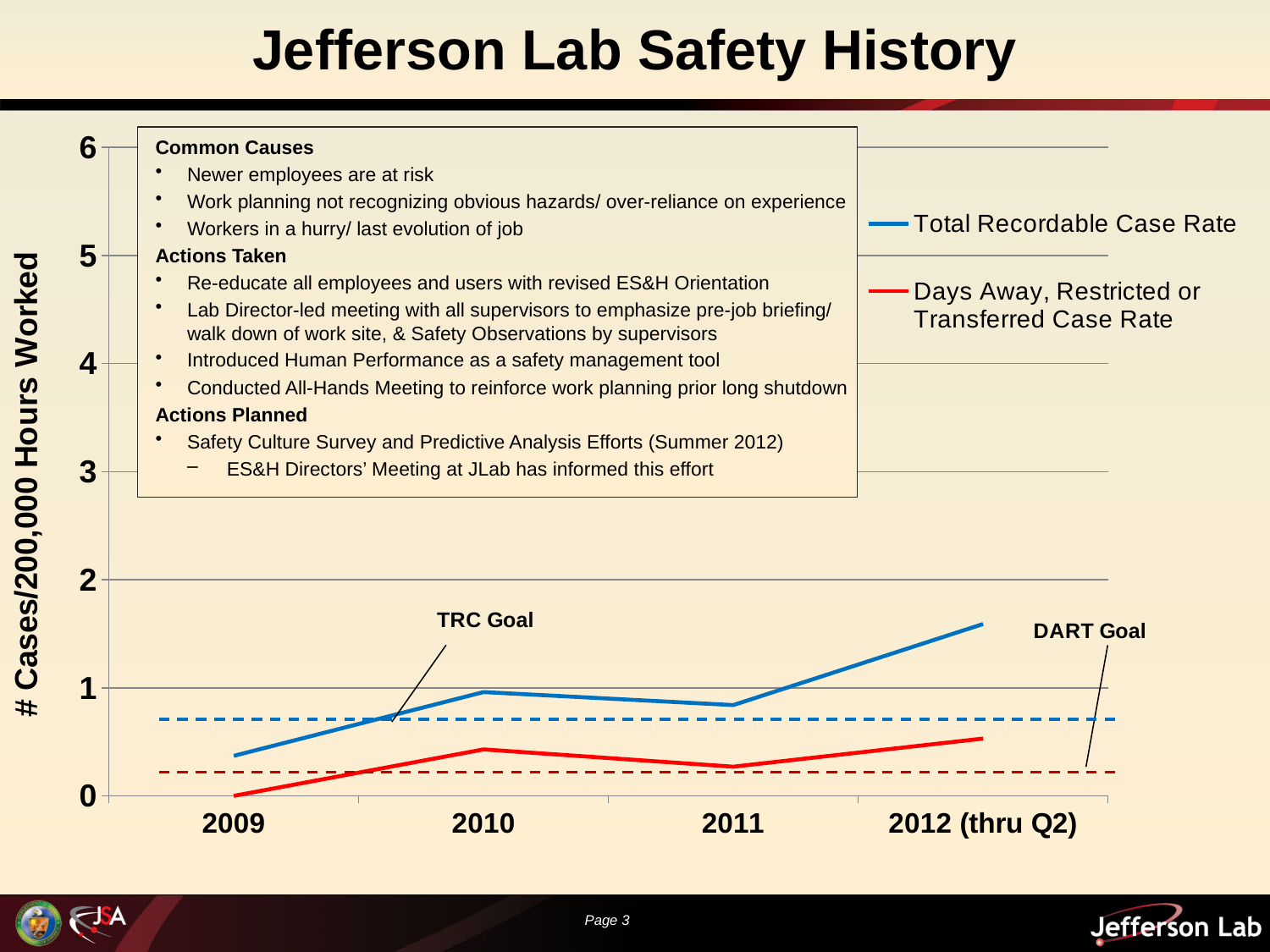
Is the Days Away, Restricted or Transferred Case Rate for 2010 greater or less than 1? less Is the Total Recordable Case Rate for 2012 (thru Q2) greater or less than 1? greater In which year is the Total Recordable Case Rate highest? 2012 (thru Q2) What kind of chart is shown on the slide? line chart In which year is the Days Away, Restricted or Transferred Case Rate lowest? 2009 How many years are shown along the x axis of the chart? 4 What colour is the line for the Days Away, Restricted or Transferred Case Rate? red How many series does the chart legend list? 2 What is the title of the y axis of the chart? # Cases/200,000 Hours Worked Does the Total Recordable Case Rate rise or fall from 2011 to 2012 (thru Q2)? rise Which is larger in 2010, the Total Recordable Case Rate or the Days Away, Restricted or Transferred Case Rate? Total Recordable Case Rate Is the Total Recordable Case Rate for 2009 greater or less than 1? less